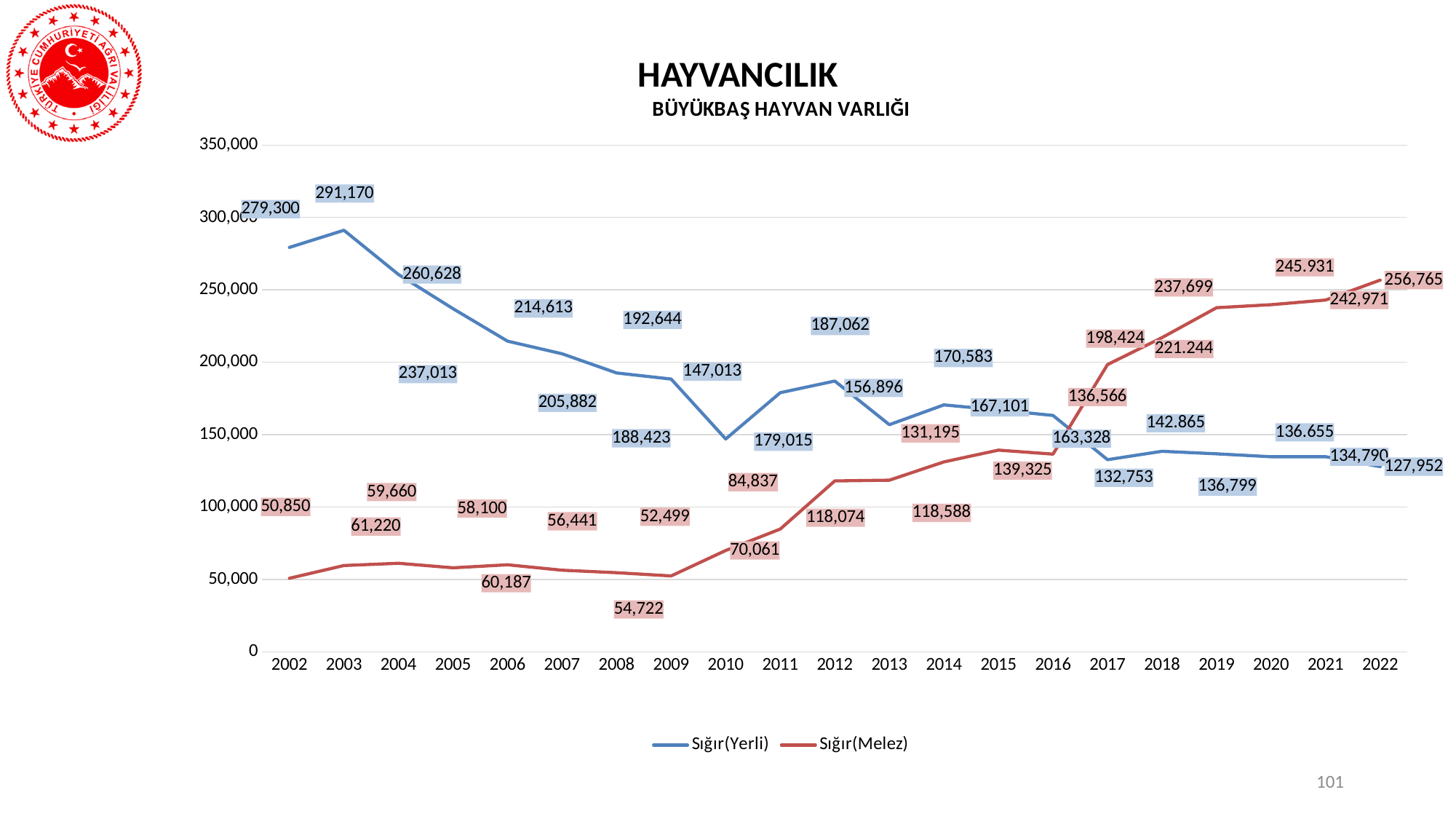
What is the subtitle of the chart? BÜYÜKBAŞ HAYVAN VARLIĞI What is the difference between Sığır(Yerli) in 2002 and Sığır(Melez) in 2002? 228,450 How many years are plotted along the x axis? 21 Does the Sığır(Melez) series generally rise or fall from 2002 to 2022? rise How many series does the legend list? 2 What kind of chart is shown on the slide? line chart In which year is the Sığır(Melez) series at its lowest? 2002 In which year is the Sığır(Yerli) series at its highest? 2003 What is the value for Sığır(Melez) in 2002? 50,850 What is the value for Sığır(Yerli) in 2003? 291,170 Which series has the larger value in 2022, Sığır(Yerli) or Sığır(Melez)? Sığır(Melez) What is the value for Sığır(Melez) in 2022? 256,765